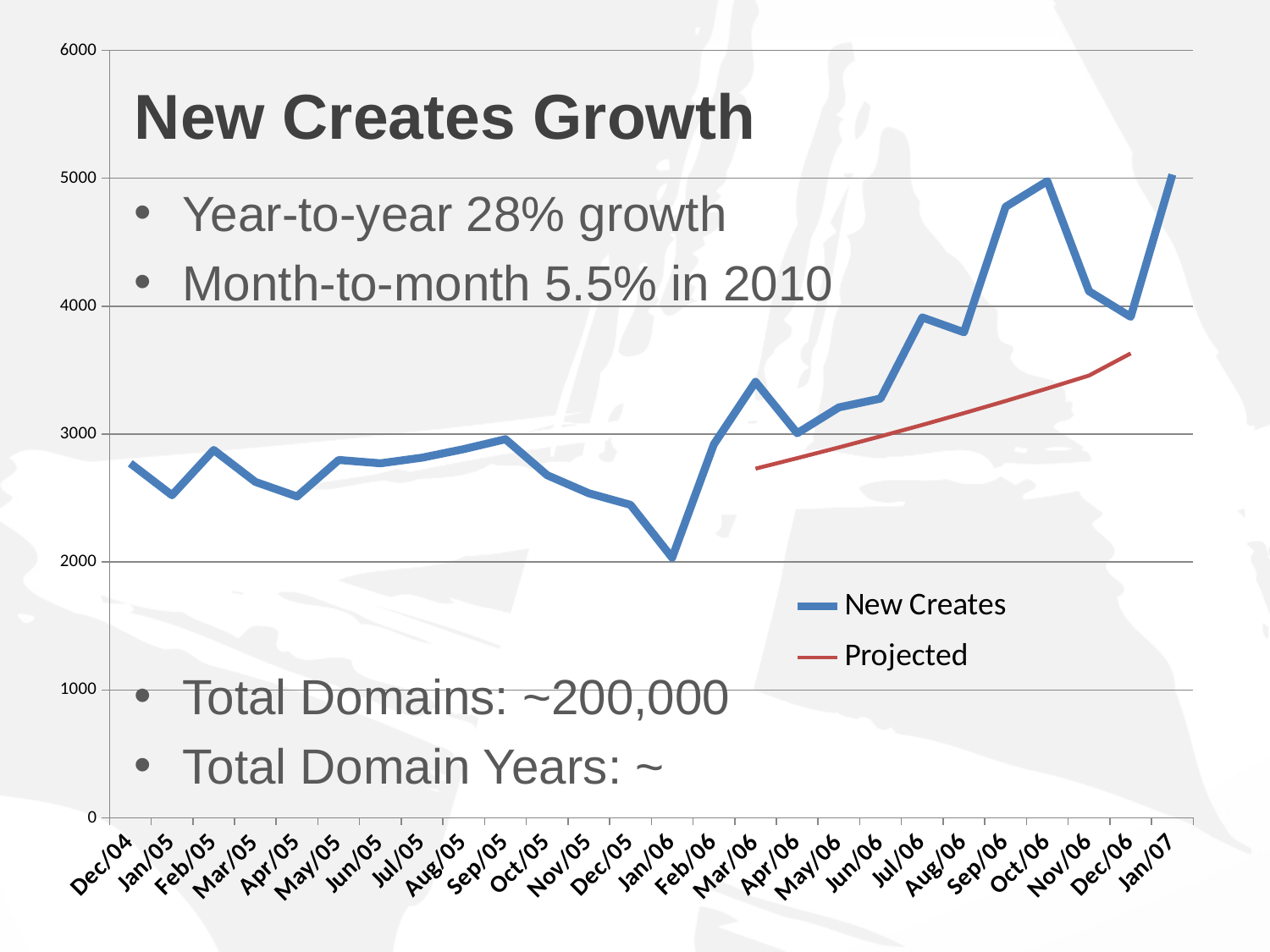
Does the Projected series rise or fall from Mar/06 to Dec/06? rise How many series does the legend list? 2 Which is larger, the New Creates value for Oct/06 or for Dec/06? Oct/06 How many months are shown along the x axis? 26 Which is larger, the New Creates value for Jan/06 or for Feb/06? Feb/06 What kind of chart is shown on the slide? line chart What is the title of the chart? New Creates Growth Is the New Creates value for Jan/06 greater or less than 3000? less Is the New Creates value for Oct/06 greater or less than 4000? greater In which month does the New Creates series reach its lowest value? Jan/06 Is the Projected value for Dec/06 greater or less than 3000? greater What are the two series named in the legend? New Creates and Projected